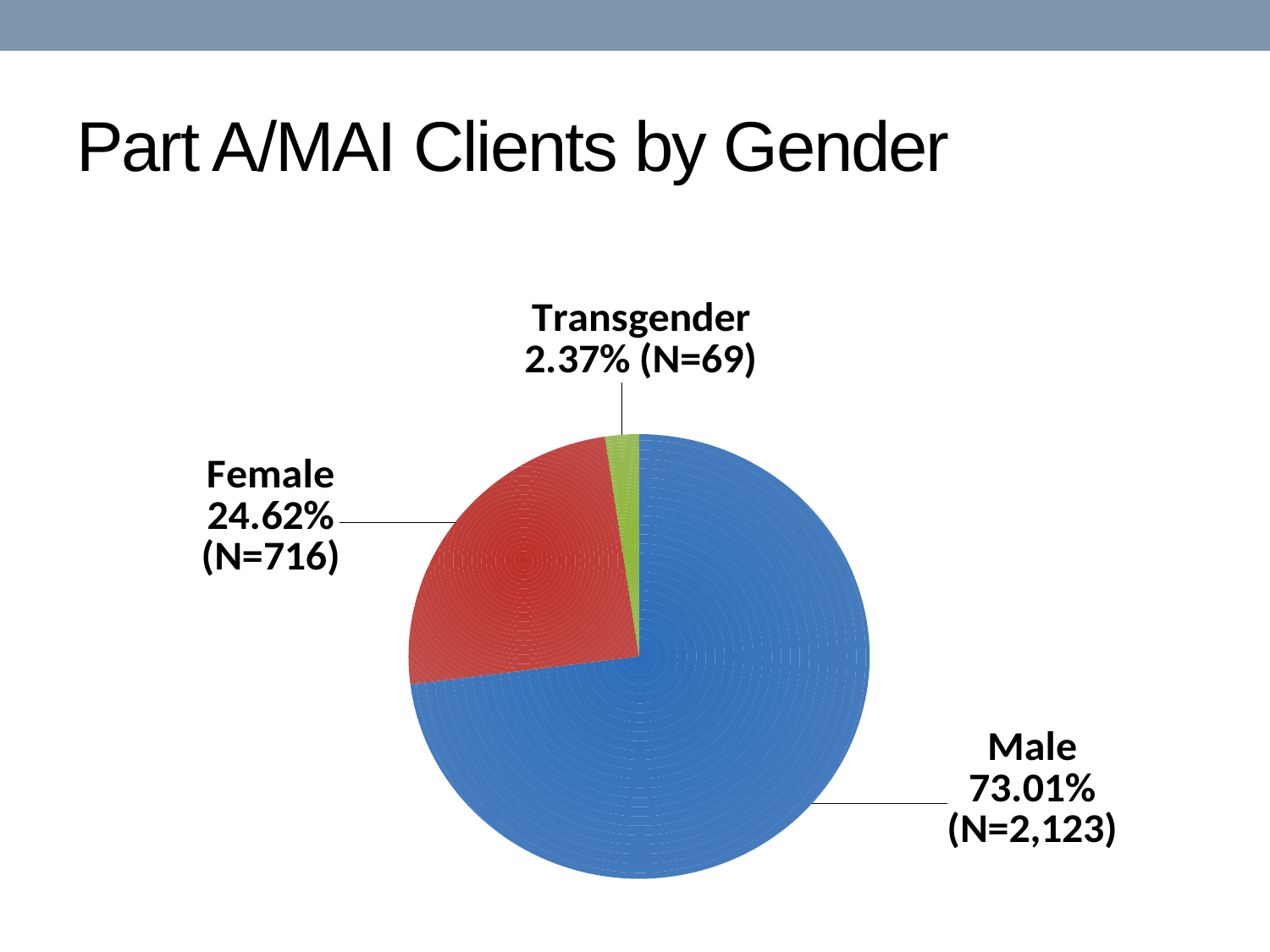
What is the title of the slide? Part A/MAI Clients by Gender How many categories does the pie chart show? 3 What kind of chart is shown on the slide? pie chart How many Male clients (N) are shown on the chart? 2,123 Which gender category has the largest share of the pie? Male What percentage of Part A/MAI clients are Transgender? 2.37% What percentage of Part A/MAI clients are Male? 73.01% How many Female clients (N) are shown on the chart? 716 Which gender category has the smallest share of the pie? Transgender How many Transgender clients (N) are shown on the chart? 69 What percentage of Part A/MAI clients are Female? 24.62% What is the difference in percentage points between the Male and Female shares? 48.39